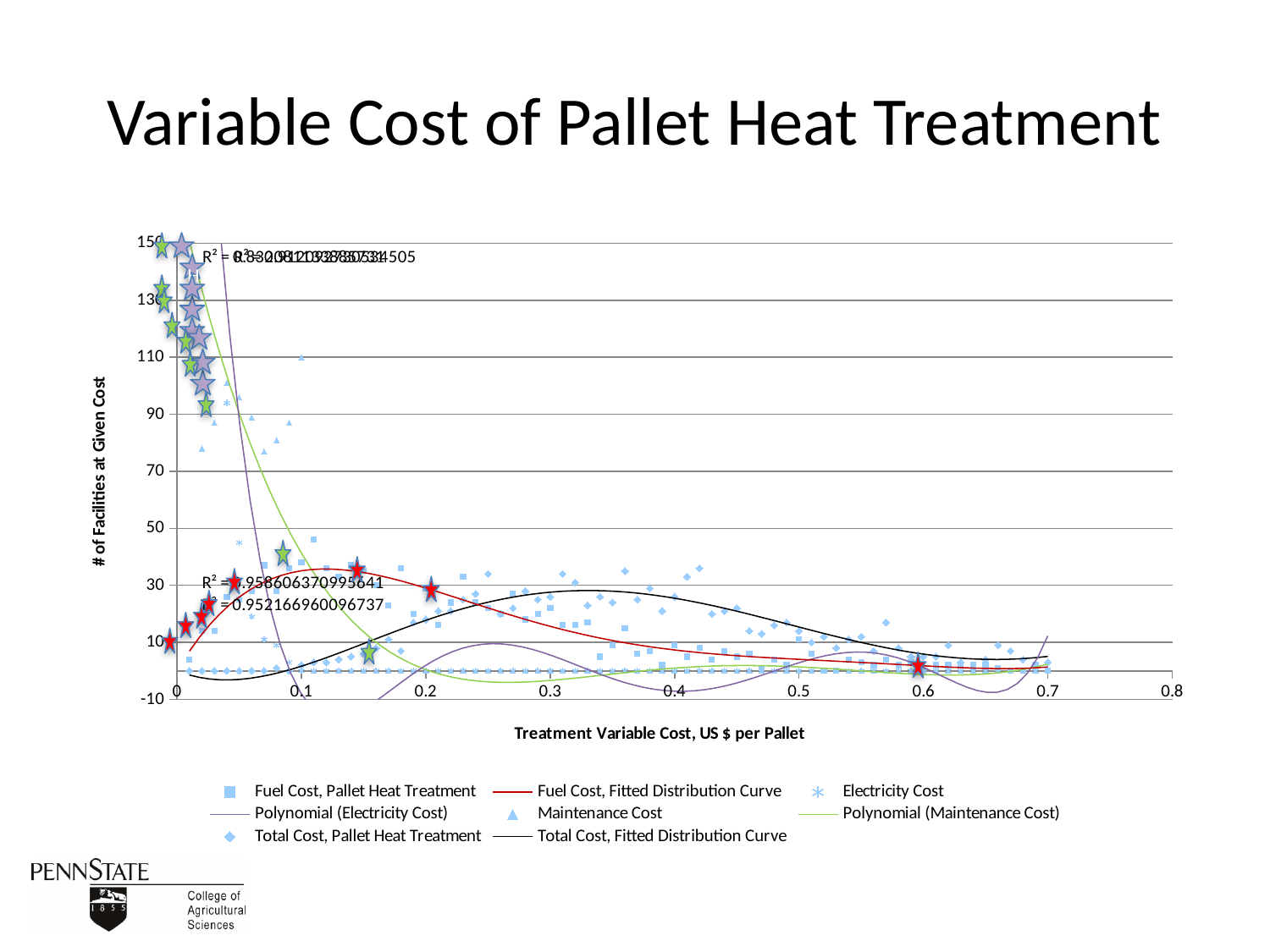
Which series has more facilities at a treatment variable cost near 0: Maintenance Cost or Fuel Cost, Pallet Heat Treatment? Maintenance Cost Does the green Polynomial (Maintenance Cost) curve rise or fall as the treatment variable cost increases from 0 to 0.2? Fall What is the R² value printed next to the red fitted curve near the 30 gridline? 0.958606370995641 What type of chart is shown on the slide? Scatter chart What is the R² value printed just below the 30 gridline, beneath the other R² value? 0.952166960096737 What is the title of the chart? Variable Cost of Pallet Heat Treatment How many series does the legend list? 8 Is the peak of the Fuel Cost, Fitted Distribution Curve greater or less than 50 facilities? less What is the label of the vertical axis? # of Facilities at Given Cost